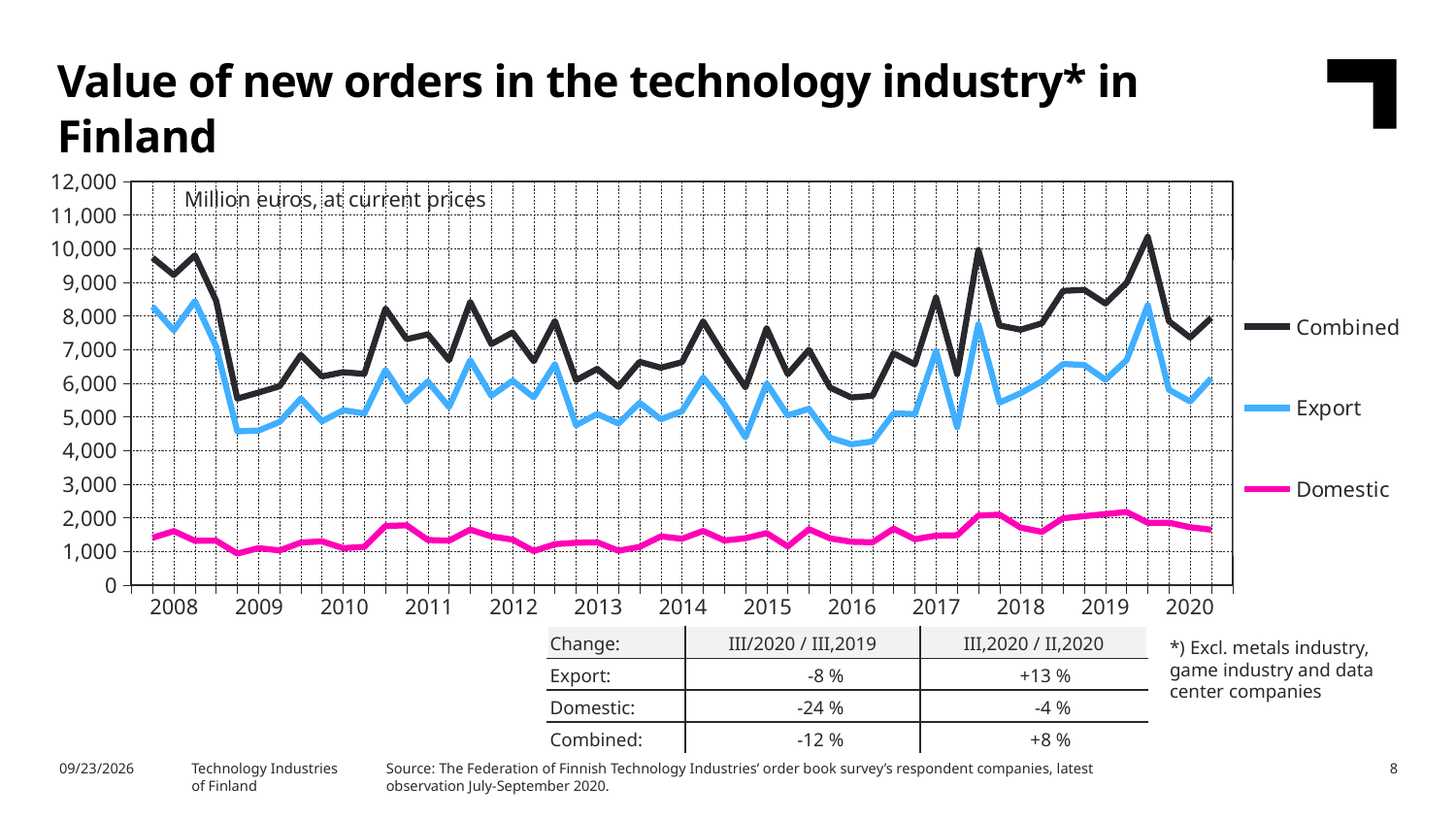
How many series does the legend list? 3 What unit is stated in the label inside the chart area? Million euros, at current prices Is the value for Domestic in 2008 greater or less than 3,000? less Is the peak value for Combined in 2019 greater or less than 10,000? greater Is the value for Combined at the start of 2009 greater or less than 7,000? less What kind of chart is shown on the slide? line chart Which series has the highest values throughout the chart? Combined Which series has the lowest values throughout the chart? Domestic Which is larger in 2020, the Combined value or the Domestic value? Combined Does the Combined series rise or fall from the start of 2008 to the start of 2009? fall How many years are labelled on the x axis? 13